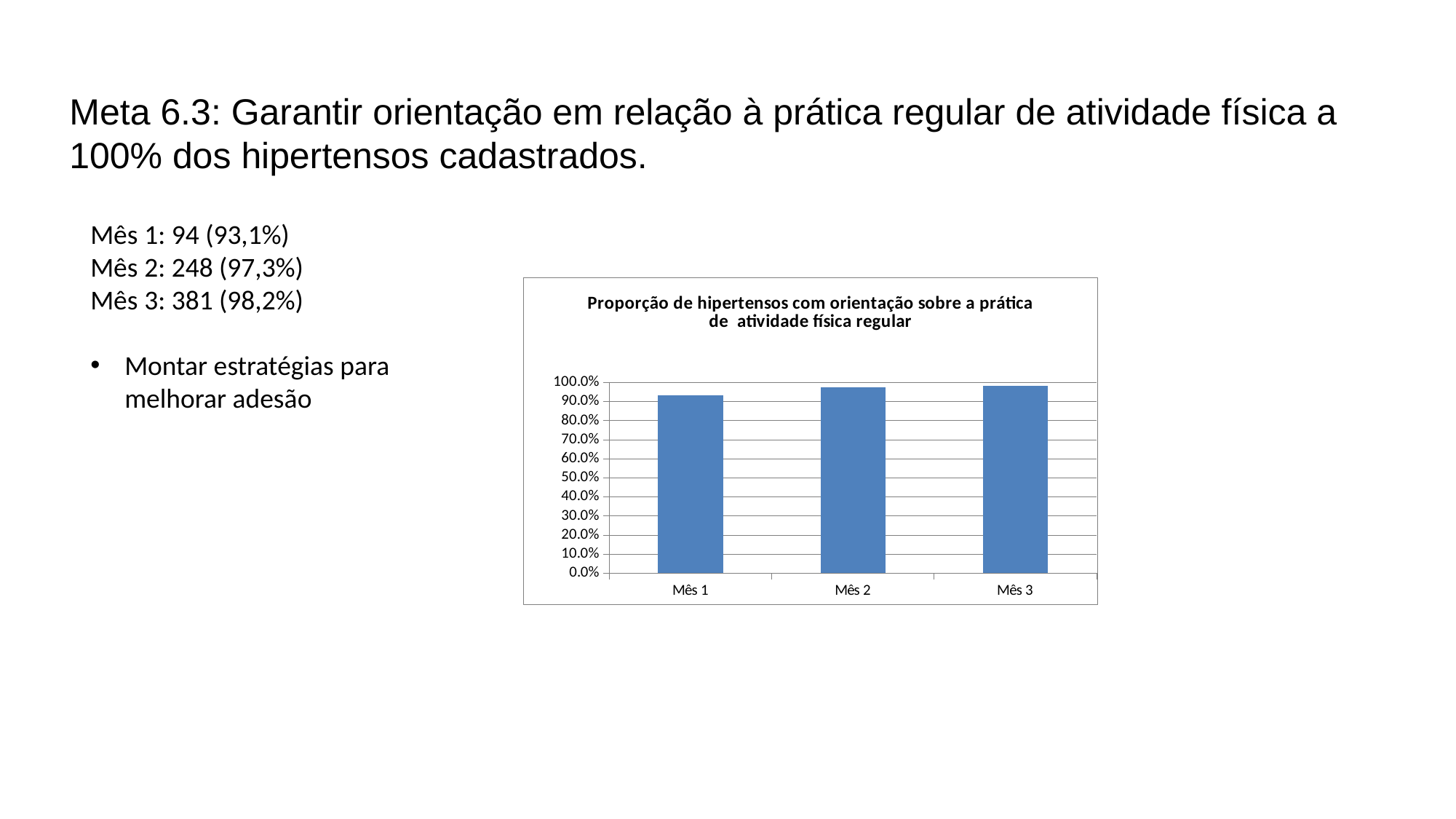
How many categories are plotted on the x axis of the chart? 3 Is the value for Mês 3 greater or less than 90.0%? greater Is the value for Mês 2 greater or less than 100.0%? less Which is larger, the value for Mês 1 or the value for Mês 2? Mês 2 Do the values rise or fall from Mês 1 to Mês 3? rise What is the title of the chart? Proporção de hipertensos com orientação sobre a prática de atividade física regular Which category has the lowest bar in the chart? Mês 1 Is the value for Mês 1 greater or less than 90.0%? greater Which is larger, the value for Mês 1 or the value for Mês 3? Mês 3 What kind of chart is shown on the slide? bar chart What is the highest tick value shown on the y axis of the chart? 100.0%